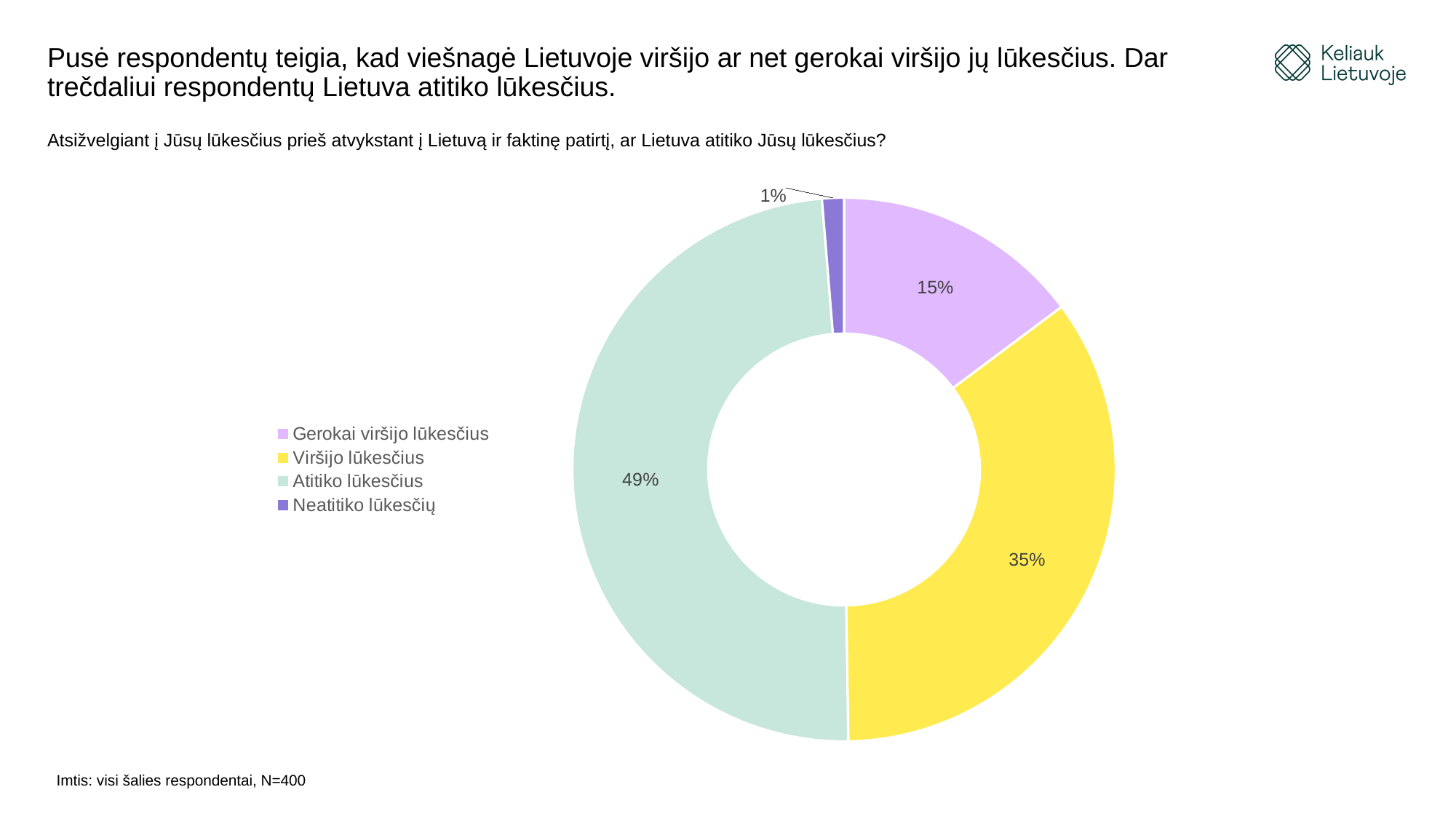
What is the combined share of "Gerokai viršijo lūkesčius" and "Viršijo lūkesčius"? 50% Which category has the largest share of the pie? Atitiko lūkesčius What kind of chart is shown on the slide? Pie chart (donut) What is the difference in percentage points between "Atitiko lūkesčius" and "Viršijo lūkesčius"? 14 What share of respondents answered "Neatitiko lūkesčių"? 1% What share of respondents answered "Viršijo lūkesčius"? 35% Which is larger: the share for "Gerokai viršijo lūkesčius" or the share for "Viršijo lūkesčius"? Viršijo lūkesčius How many categories does the legend list? 4 What share of respondents answered "Atitiko lūkesčius"? 49% What share of respondents answered "Gerokai viršijo lūkesčius"? 15% Which category has the smallest share of the pie? Neatitiko lūkesčių What colour is the "Viršijo lūkesčius" slice? Yellow